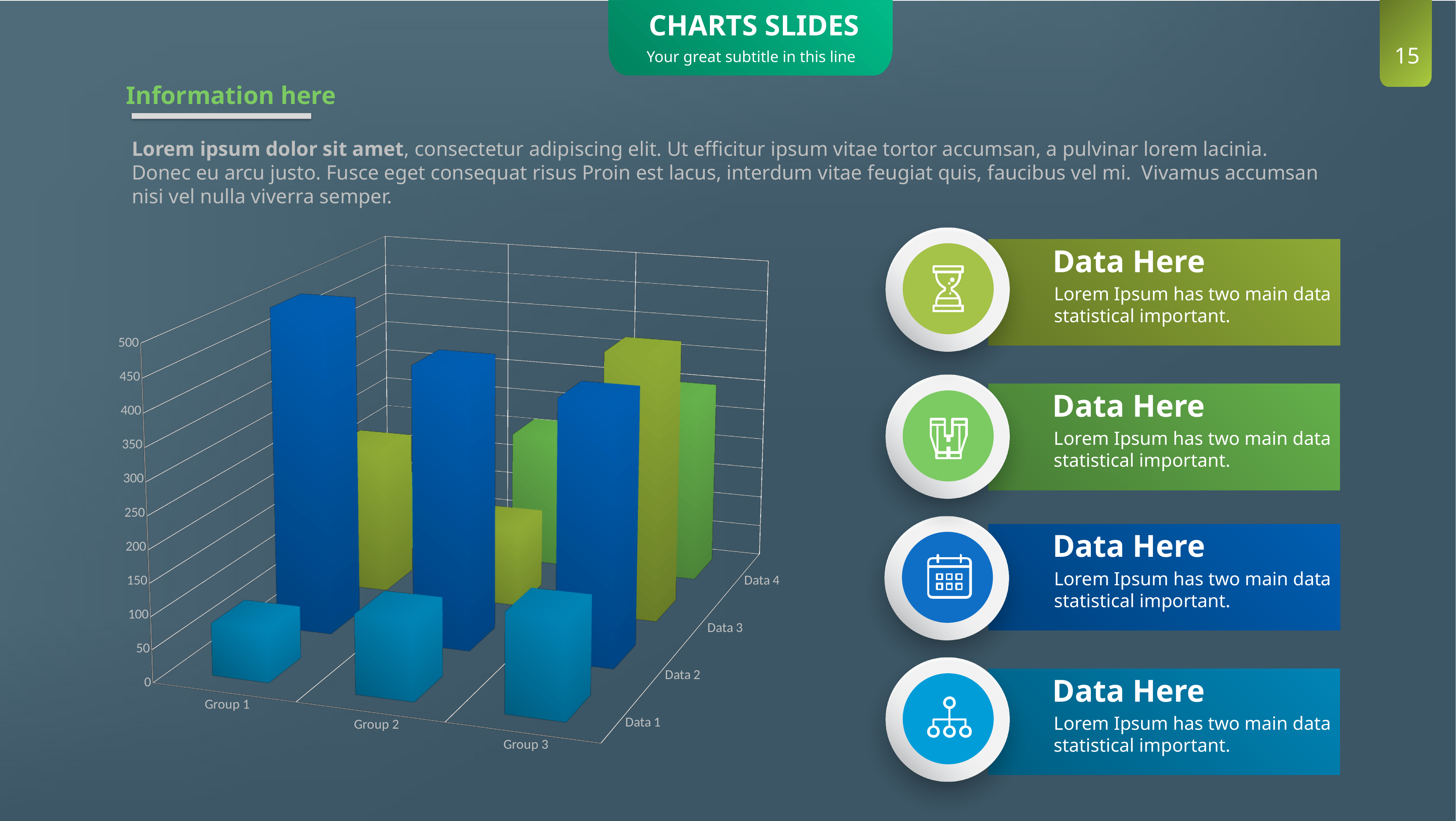
Which group has the lowest value in the Data 3 series? Group 2 Which is larger for Group 1: the Data 2 value or the Data 1 value? Data 2 How many data series (Data 1 to Data 4) does the chart plot? 4 Which group has the lowest value in the Data 1 series? Group 1 Is the value for Group 1 in the Data 1 series greater or less than 200? less Is the value for Group 2 in the Data 3 series greater or less than 400? less Is the value for Group 1 in the Data 2 series greater or less than 400? greater How many groups are shown along the x axis of the chart? 3 What kind of chart is shown on the slide? bar chart Which group has the highest value in the Data 2 series? Group 1 Do the Data 2 values rise or fall from Group 1 to Group 3? fall What is the highest value labelled on the chart's vertical axis? 500